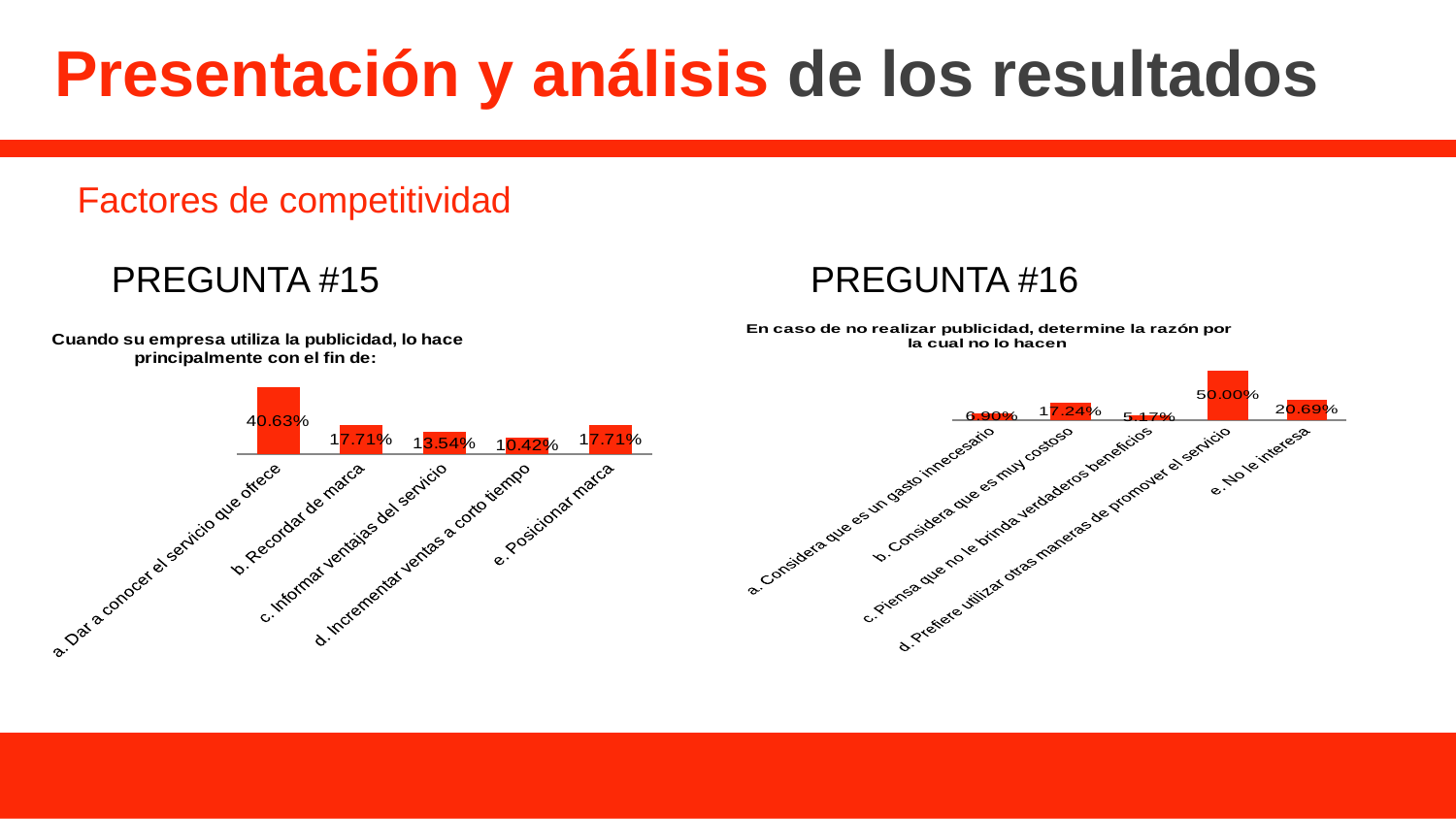
In the PREGUNTA #15 chart, what is the difference between 'a. Dar a conocer el servicio que ofrece' and 'c. Informar ventajas del servicio'? 27.09% In the PREGUNTA #15 chart, what is the value for 'd. Incrementar ventas a corto tiempo'? 10.42% In the PREGUNTA #16 chart, which is larger: 'b. Considera que es muy costoso' or 'e. No le interesa'? e. No le interesa What kind of chart is the PREGUNTA #16 chart? Bar chart In the PREGUNTA #15 chart, what is the value for 'a. Dar a conocer el servicio que ofrece'? 40.63% In the PREGUNTA #15 chart, how many categories are shown? 5 In the PREGUNTA #15 chart, which category has the highest value? a. Dar a conocer el servicio que ofrece In the PREGUNTA #15 chart, which category has the lowest value? d. Incrementar ventas a corto tiempo In the PREGUNTA #16 chart, what is the value for 'd. Prefiere utilizar otras maneras de promover el servicio'? 50.00% In the PREGUNTA #16 chart, what is the difference between 'd. Prefiere utilizar otras maneras de promover el servicio' and 'a. Considera que es un gasto innecesario'? 43.10% In the PREGUNTA #16 chart, which category has the lowest value? c. Piensa que no le brinda verdaderos beneficios In the PREGUNTA #16 chart, what is the value for 'e. No le interesa'? 20.69%